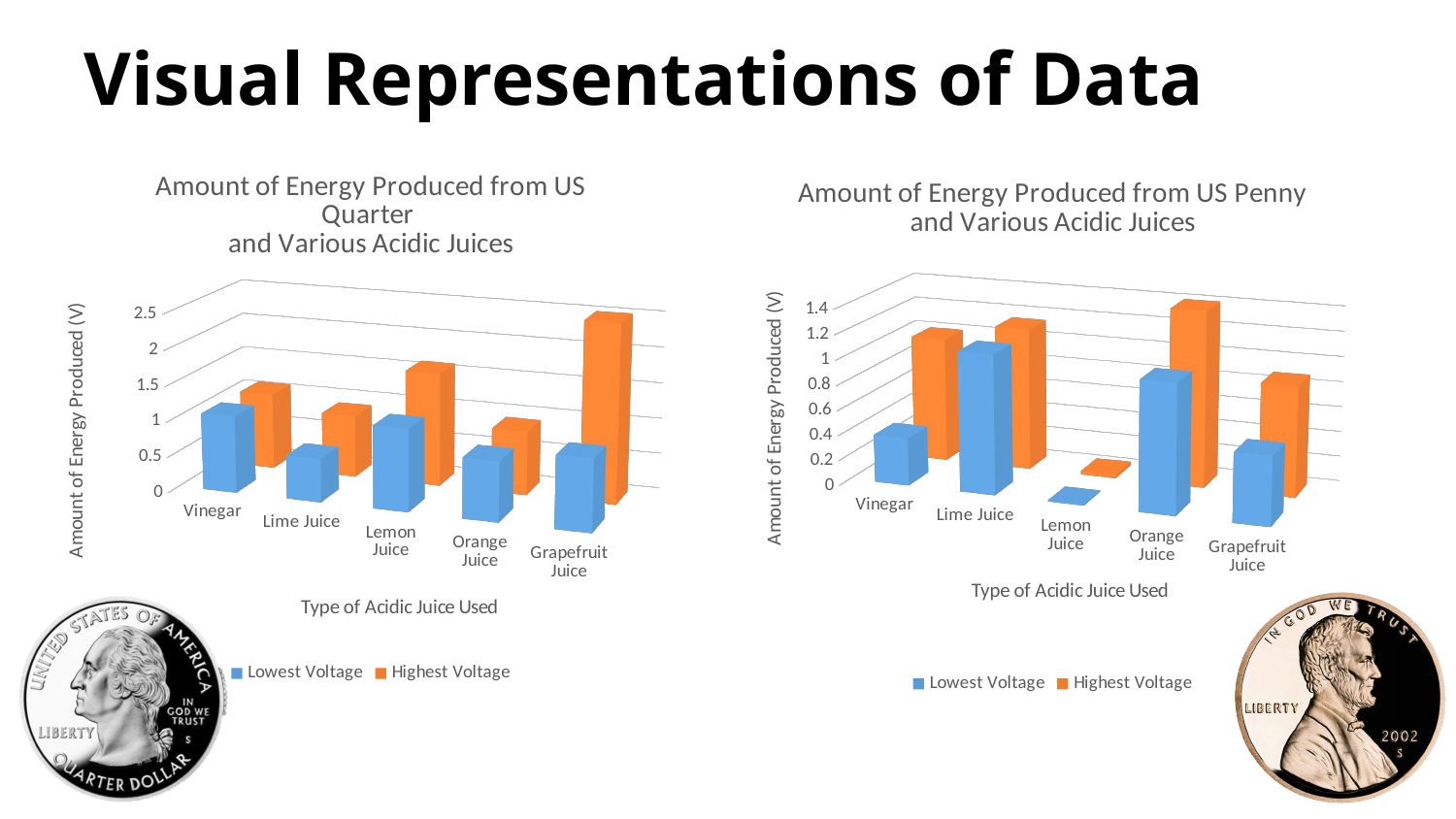
How many types of acidic juice are shown on the x axis of the US Quarter chart? 5 In the US Penny chart, which type of juice has the lowest Lowest Voltage value? Lemon Juice How many series does the legend of the US Penny chart list? 2 What is the y-axis label of the US Penny chart? Amount of Energy Produced (V) In the US Quarter chart, which type of juice has the highest Highest Voltage value? Grapefruit Juice In the US Quarter chart, is the Highest Voltage value for Grapefruit Juice greater or less than 2? greater In the US Penny chart, which type of juice has the highest Highest Voltage value? Orange Juice In the US Quarter chart, which is larger: the Lowest Voltage for Vinegar or the Lowest Voltage for Lime Juice? Vinegar In the US Quarter chart, is the Highest Voltage value for Orange Juice greater or less than 1? less In the US Penny chart, is the Lowest Voltage value for Vinegar greater or less than 0.6? less What type of chart is the 'Amount of Energy Produced from US Quarter and Various Acidic Juices' chart? bar chart